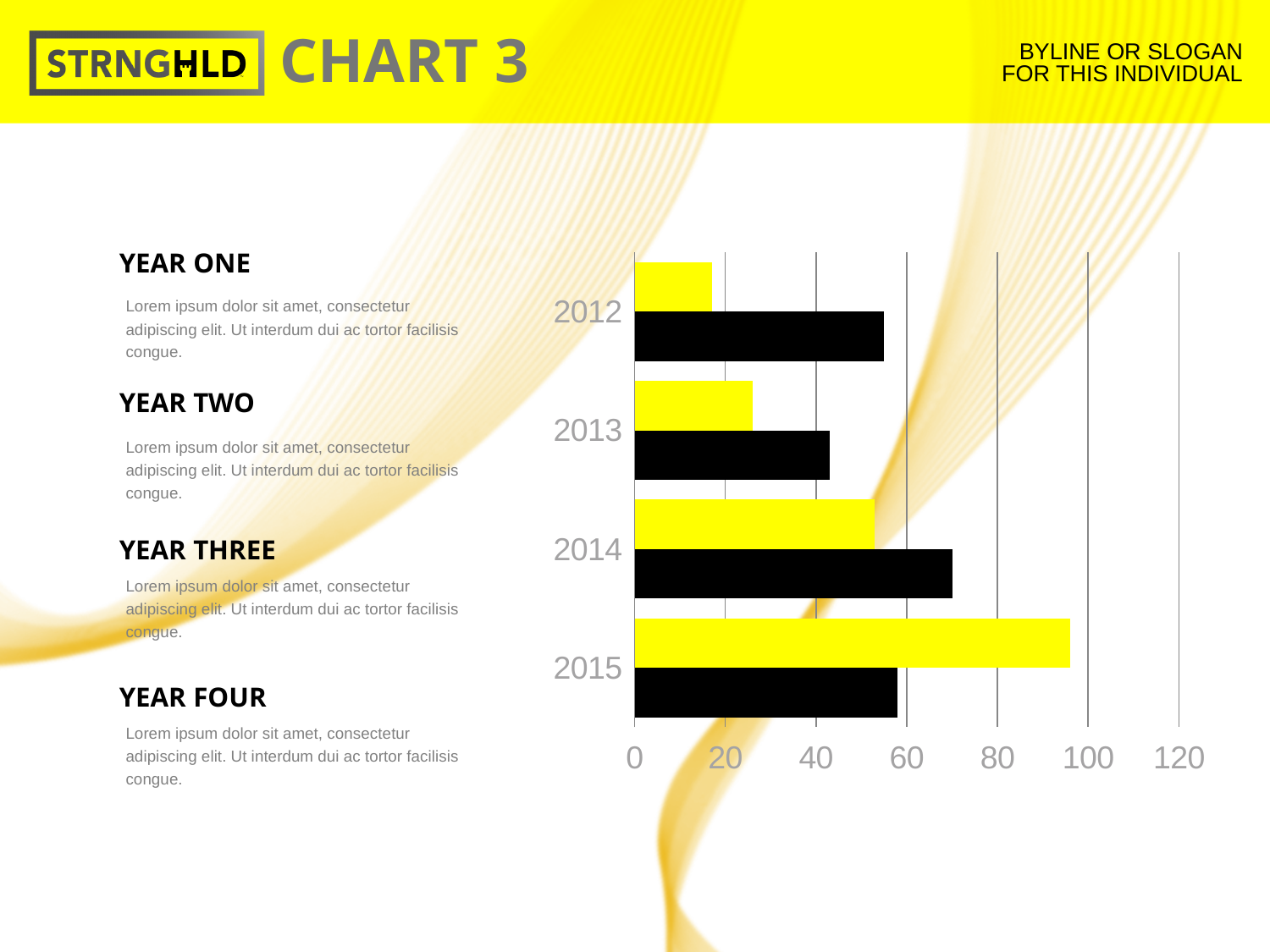
Which year has the longest black bar? 2014 Which year has the longest yellow bar? 2015 How many bars are plotted for each year on the chart? 2 Is the black bar for 2014 greater or less than 60? greater Is the yellow bar for 2012 greater or less than 20? less What kind of chart is shown on the slide? bar chart How many years are shown on the chart's vertical axis? 4 Which year has the shortest black bar? 2013 Do the yellow bars get longer or shorter going from 2012 to 2015? longer Which year has the shortest yellow bar? 2012 For 2013, which bar is longer, the yellow bar or the black bar? the black bar Is the yellow bar for 2015 greater or less than 80? greater